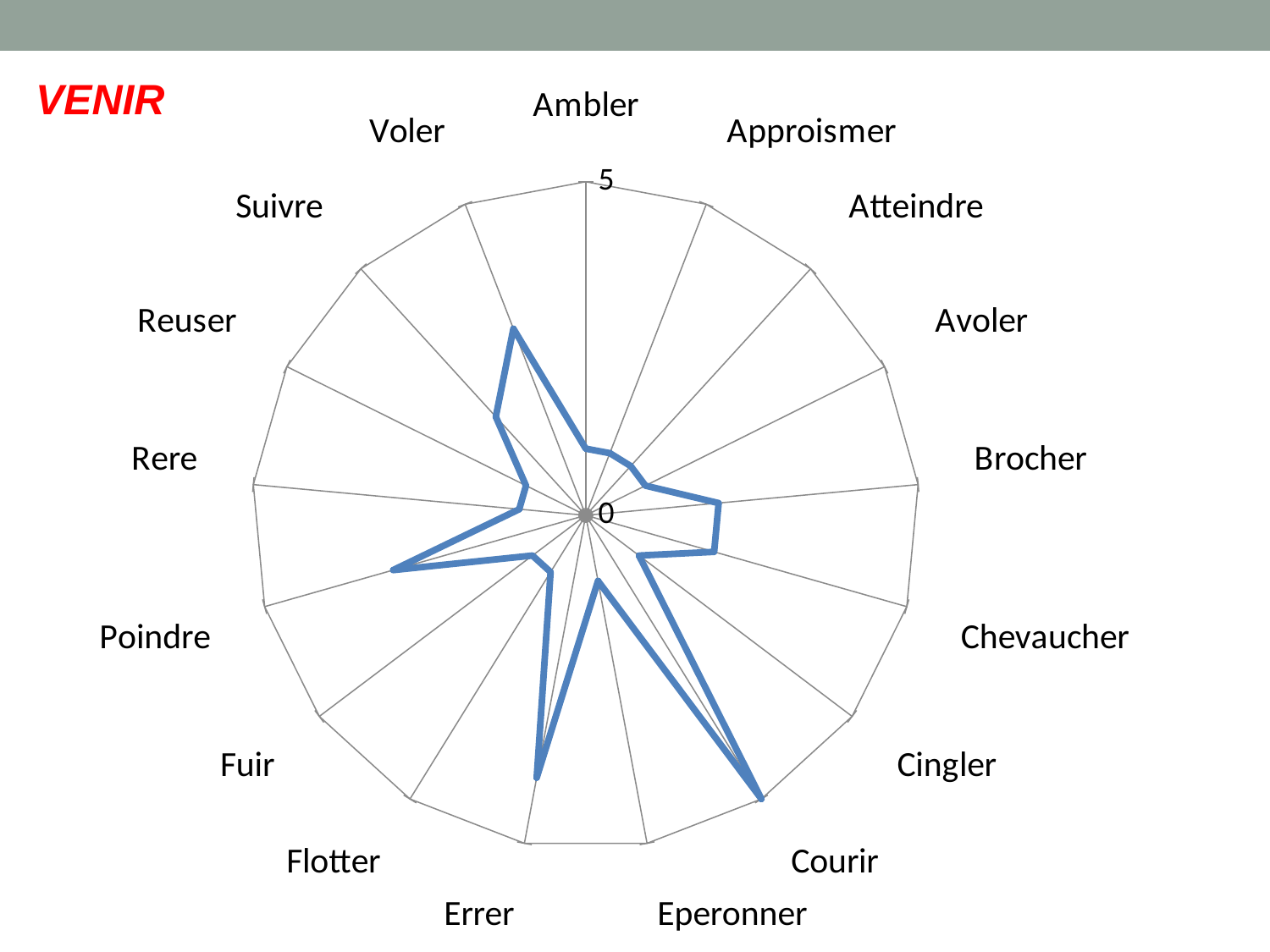
How many categories (verbs) are plotted around the radar chart? 17 Which has the larger value, Poindre or Brocher? Poindre What kind of chart is shown on the slide? radar chart Which has the larger value, Courir or Ambler? Courir Which has the larger value, Errer or Brocher? Errer Which category has the highest value on the radar chart? Courir What title is shown in red at the top left of the slide? VENIR What is the maximum value shown on the radar chart's axis? 5